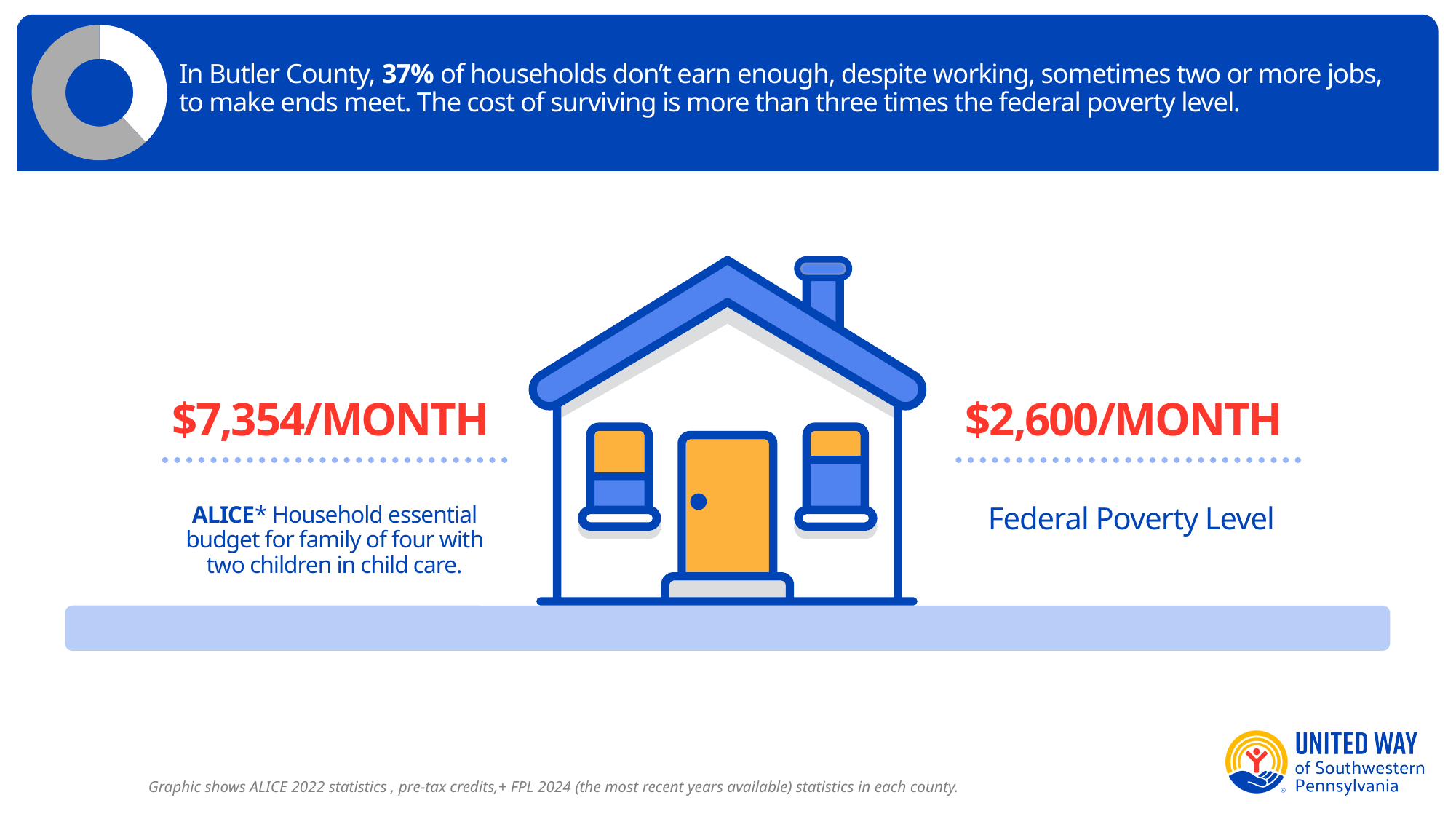
What kind of chart is shown in the top-left corner of the slide? Donut chart How many slices does the donut chart have? 2 Which is larger, the ALICE household essential budget or the Federal Poverty Level? ALICE household essential budget Which county does the slide's donut chart statistic refer to? Butler County What is the difference between the ALICE household essential budget and the Federal Poverty Level per month? $4,754 What is the Federal Poverty Level per month shown on the slide? $2,600/MONTH In the donut chart, which slice is larger, the blue slice or the gray slice? The gray slice What share of Butler County households does the blue slice of the donut chart represent? 37% Is the share shown by the blue slice of the donut chart greater or less than 50%? less What colour is the slice of the donut chart that represents the 37% of households that don't earn enough? Blue What is the ALICE household essential budget per month shown on the slide? $7,354/MONTH